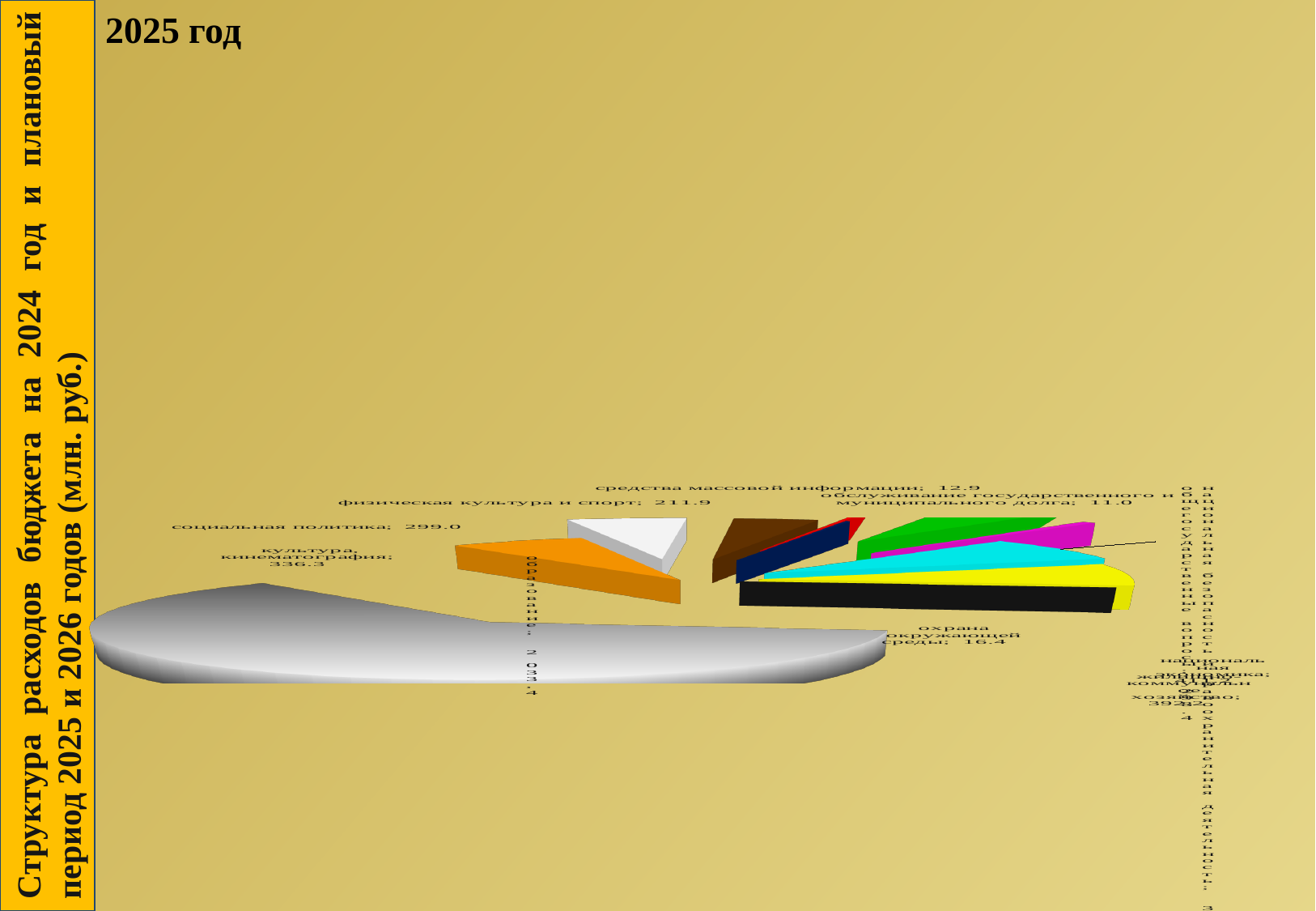
What is the value for физическая культура и спорт? 211.9 What is the value for средства массовой информации? 12.9 Which category has the smallest value shown? обслуживание государственного и муниципального долга Which category has the largest slice of the pie? образование What is the value for образование? 2033.4 What is the value for культура, кинематография? 336.3 Which is larger: социальная политика or физическая культура и спорт? социальная политика What type of chart is shown on the slide? pie chart What is the value for охрана окружающей среды? 16.4 What is the value for обслуживание государственного и муниципального долга? 11.0 What is the difference between the values for культура, кинематография and социальная политика? 37.3 What is the value for социальная политика? 299.0